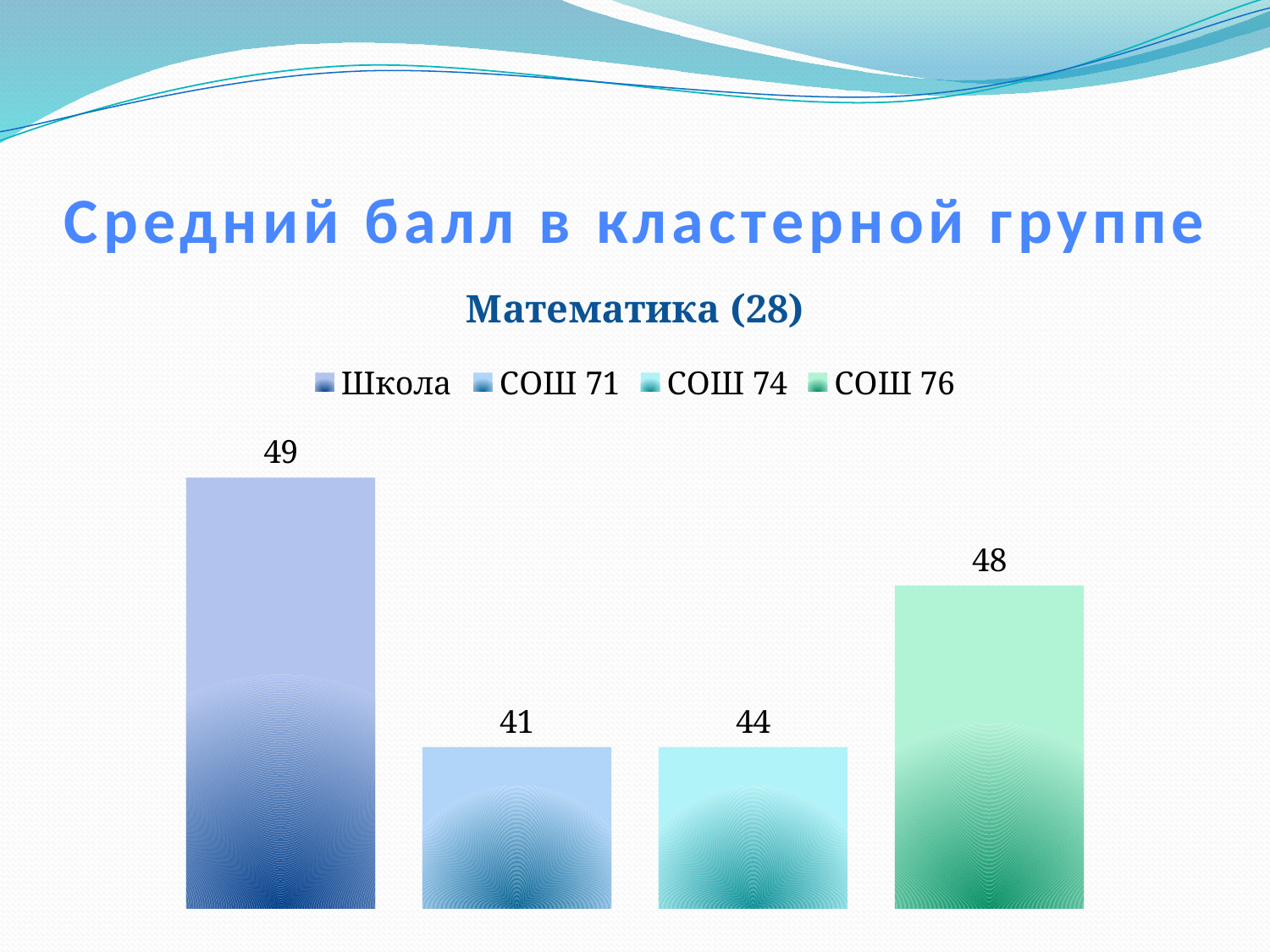
What kind of chart is shown on the slide? Bar chart What is the value for СОШ 76? 48 What is the value for Школа? 49 What is the value for СОШ 71? 41 Which is larger, the value for СОШ 74 or the value for СОШ 71? СОШ 74 What is the value for СОШ 74? 44 Which category has the lowest value? СОШ 71 How many bars are shown in the chart? 4 What is the difference between the values for Школа and СОШ 71? 8 Which category has the highest value? Школа How many entries does the legend list? 4 What is the difference between the values for СОШ 76 and СОШ 74? 4